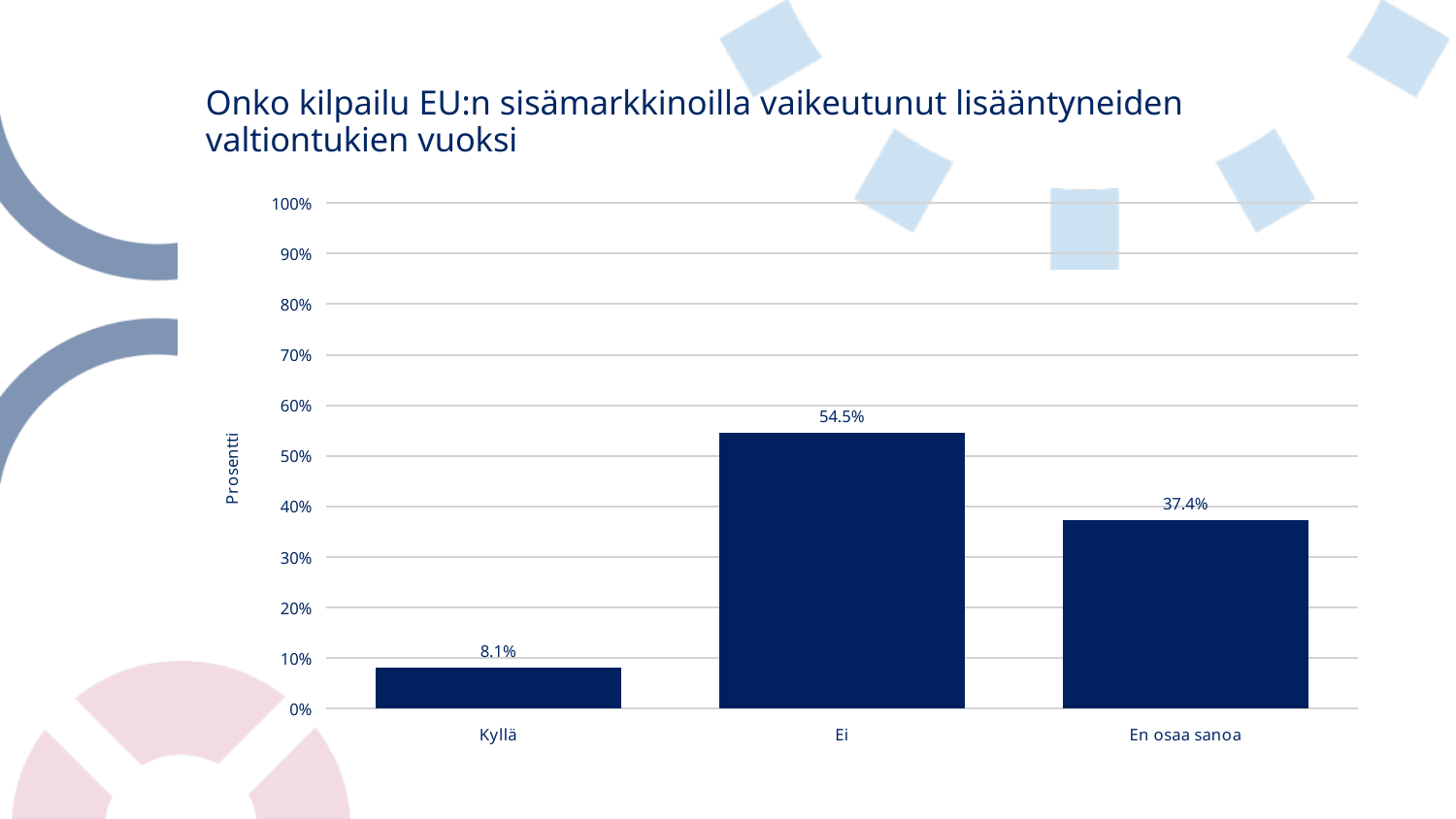
What is the difference between the values for Ei and En osaa sanoa? 17.1% What is the value for En osaa sanoa? 37.4% What is the difference between the values for En osaa sanoa and Kyllä? 29.3% What kind of chart is shown on the slide? bar chart What is the value for Kyllä? 8.1% What is the value for Ei? 54.5% Which category has the highest value? Ei Which is larger, the value for Ei or the value for En osaa sanoa? Ei What is the label of the vertical axis? Prosentti How many categories are shown on the x axis? 3 Which category has the lowest value? Kyllä Is the value for Ei greater or less than 50%? greater